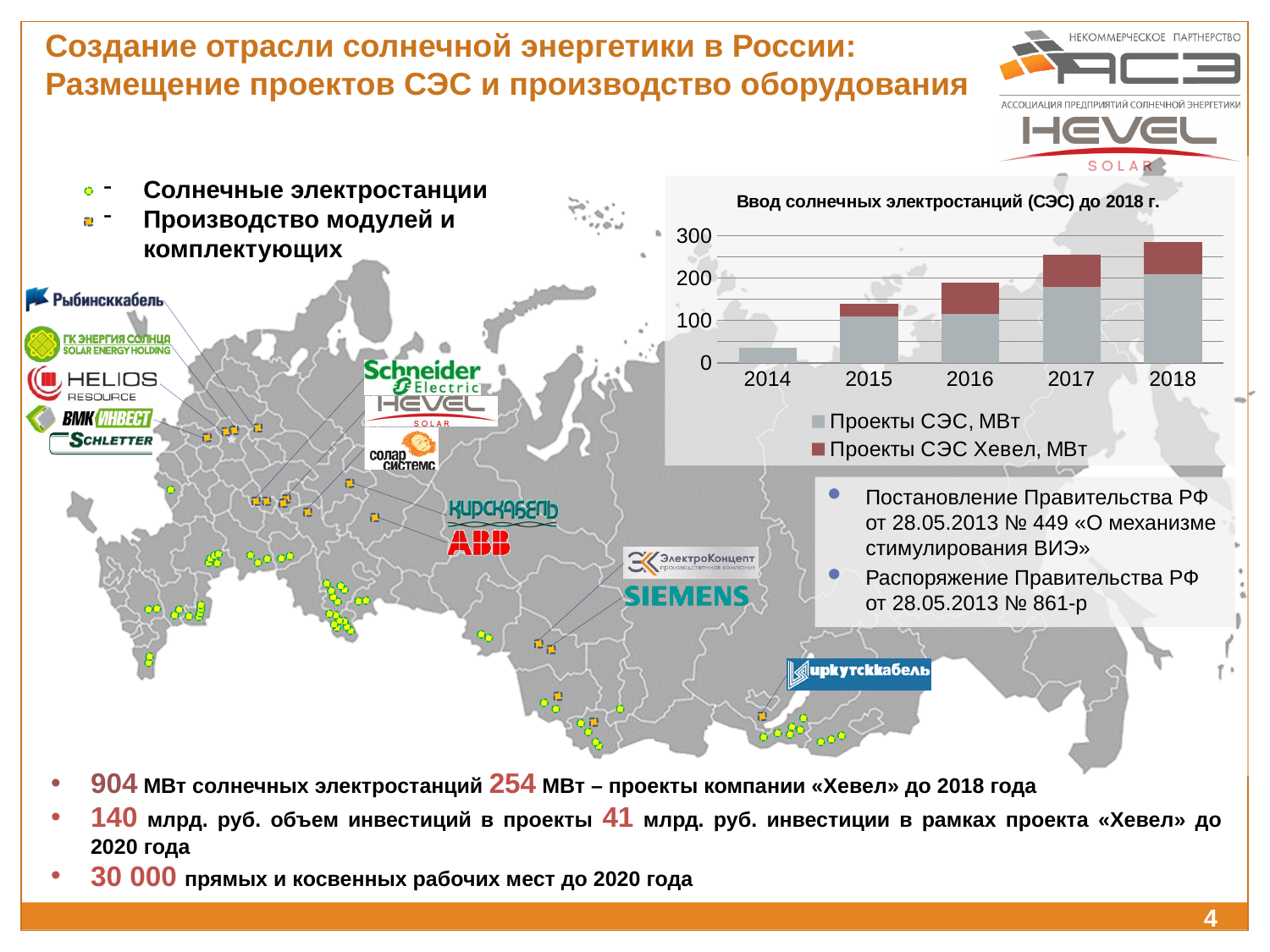
Is the total value for 2014 greater or less than 100? less Which series is shown in dark red in the chart? Проекты СЭС Хевел, МВт How many series does the chart legend list? 2 Which year has the shortest stacked bar in the chart? 2014 What kind of chart is shown on the slide? stacked bar chart Do the stacked bar totals rise or fall from 2014 to 2018? rise Which year has the tallest stacked bar in the chart? 2018 Which year has the larger stacked bar total, 2015 or 2017? 2017 Is the total value for 2018 greater or less than 200? greater What is the title of the chart on the slide? Ввод солнечных электростанций (СЭС) до 2018 г. How many years are shown on the x axis of the chart? 5 Is the total value for 2016 greater or less than 200? less